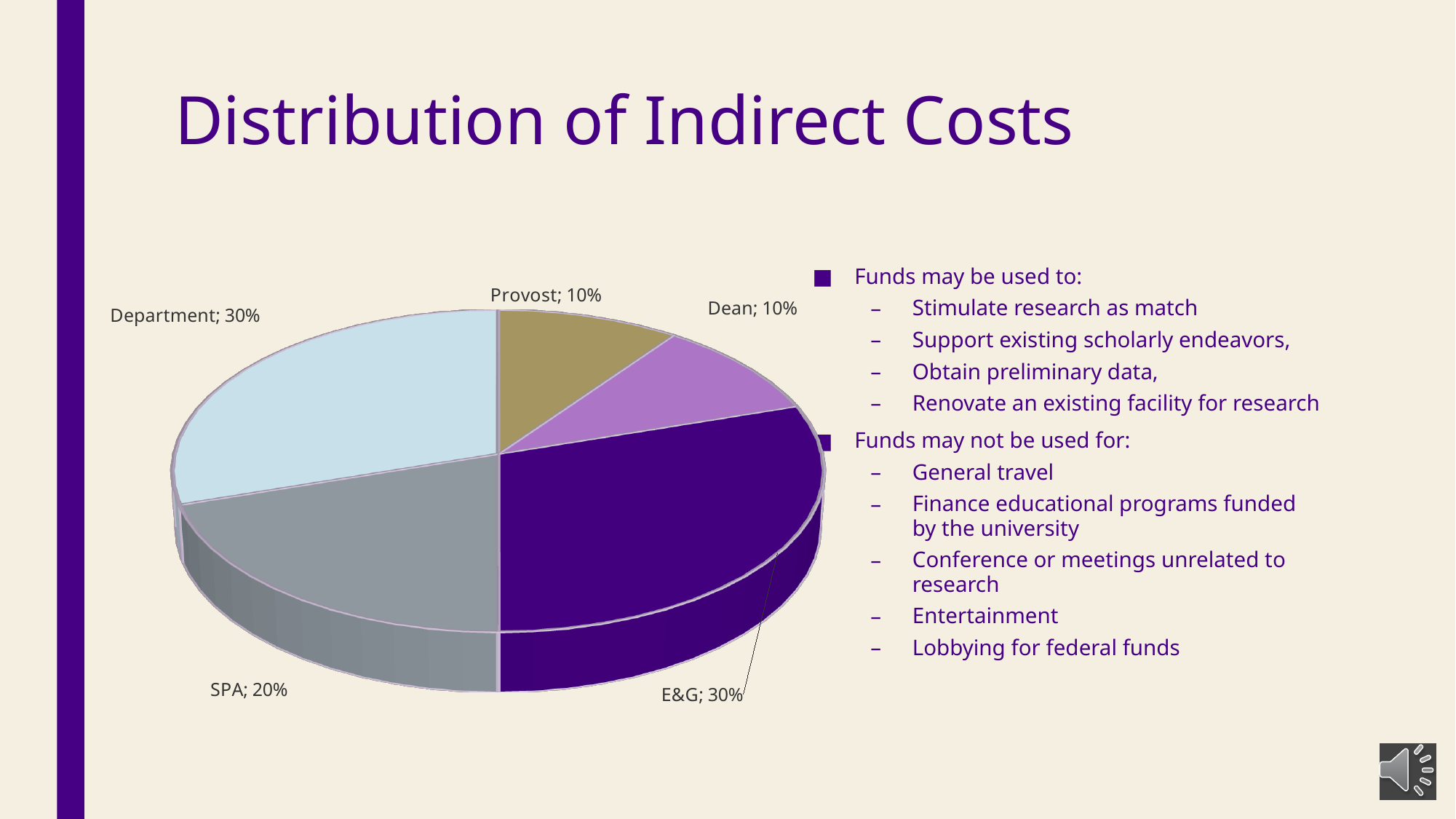
What kind of chart is shown on the slide? Pie chart How many slices does the pie chart have? 5 What share of indirect costs goes to SPA? 20% What share of indirect costs goes to the Provost? 10% Which category is shown in the dark purple slice? E&G What share of indirect costs goes to the Dean? 10% What share of indirect costs goes to the Department? 30% What share of indirect costs goes to E&G? 30% What is the difference between the SPA share and the Provost share? 10% What is the title of the chart slide? Distribution of Indirect Costs Which is larger, the share for SPA or the share for Dean? SPA What is the combined share of the Provost and Dean slices? 20%